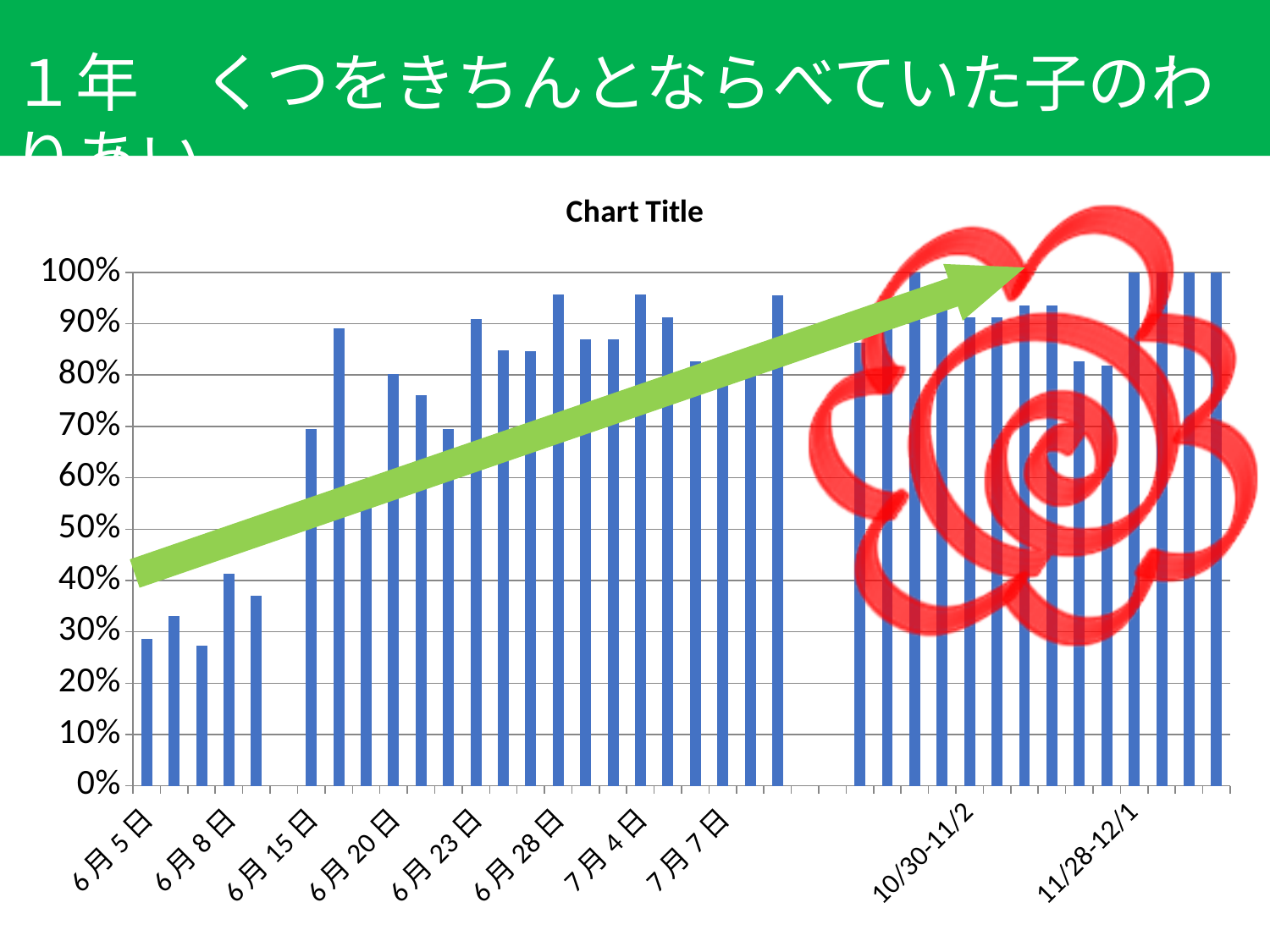
What kind of chart is shown on the slide? bar chart What is the highest value shown on the vertical axis? 100% Do the bar values generally rise or fall from left to right along the x axis? rise Is the value for 7月4日 greater or less than 90%? greater Is the value for 6月20日 greater or less than 70%? greater What is the title shown above the chart? Chart Title Is the value for 6月23日 greater or less than 80%? greater Which has the larger value, 6月5日 or 6月23日? 6月23日